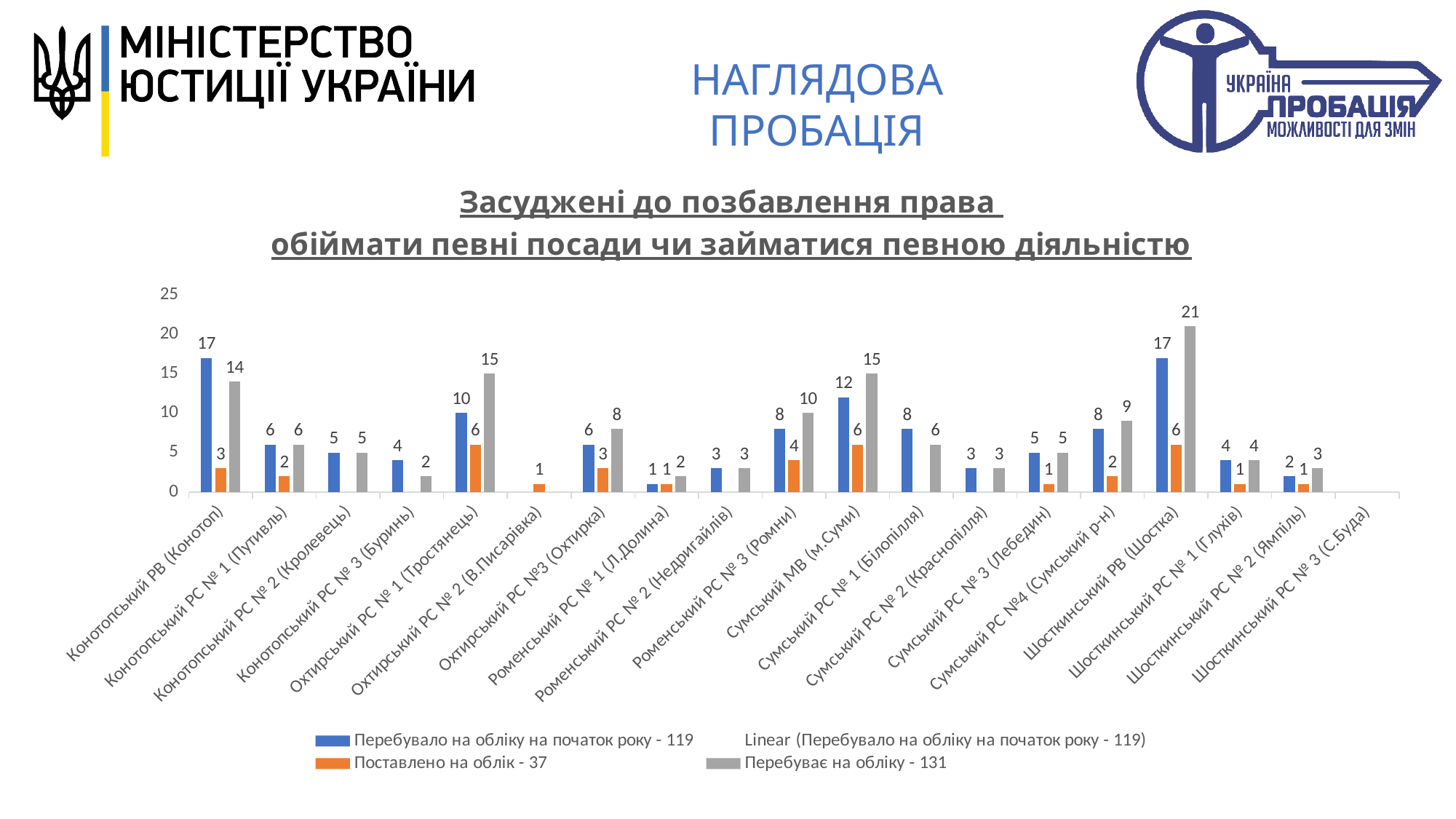
What is the value of 'Поставлено на облік' for Конотопський РВ (Конотоп)? 3 What is the value of 'Перебуває на обліку' for Роменський РС № 3 (Ромни)? 10 What is the difference between 'Перебувало на обліку на початок року' and 'Перебуває на обліку' for Конотопський РВ (Конотоп)? 3 How many categories are shown on the x axis of the chart? 19 What kind of chart is shown on the slide? bar chart Which has the larger value for 'Перебувало на обліку на початок року': Сумський МВ (м.Суми) or Охтирський РС № 1 (Тростянець)? Сумський МВ (м.Суми) How much larger is 'Перебуває на обліку' for Шосткинський РВ (Шостка) than for Конотопський РВ (Конотоп)? 7 What total is given in the legend entry for 'Поставлено на облік'? 37 What is the value of 'Перебуває на обліку' for Шосткинський РВ (Шостка)? 21 Which category has the highest value for 'Перебуває на обліку'? Шосткинський РВ (Шостка) What is the value of 'Перебувало на обліку на початок року' for Охтирський РС № 1 (Тростянець)? 10 Is the value of 'Перебуває на обліку' for Шосткинський РВ (Шостка) greater or less than 20? greater